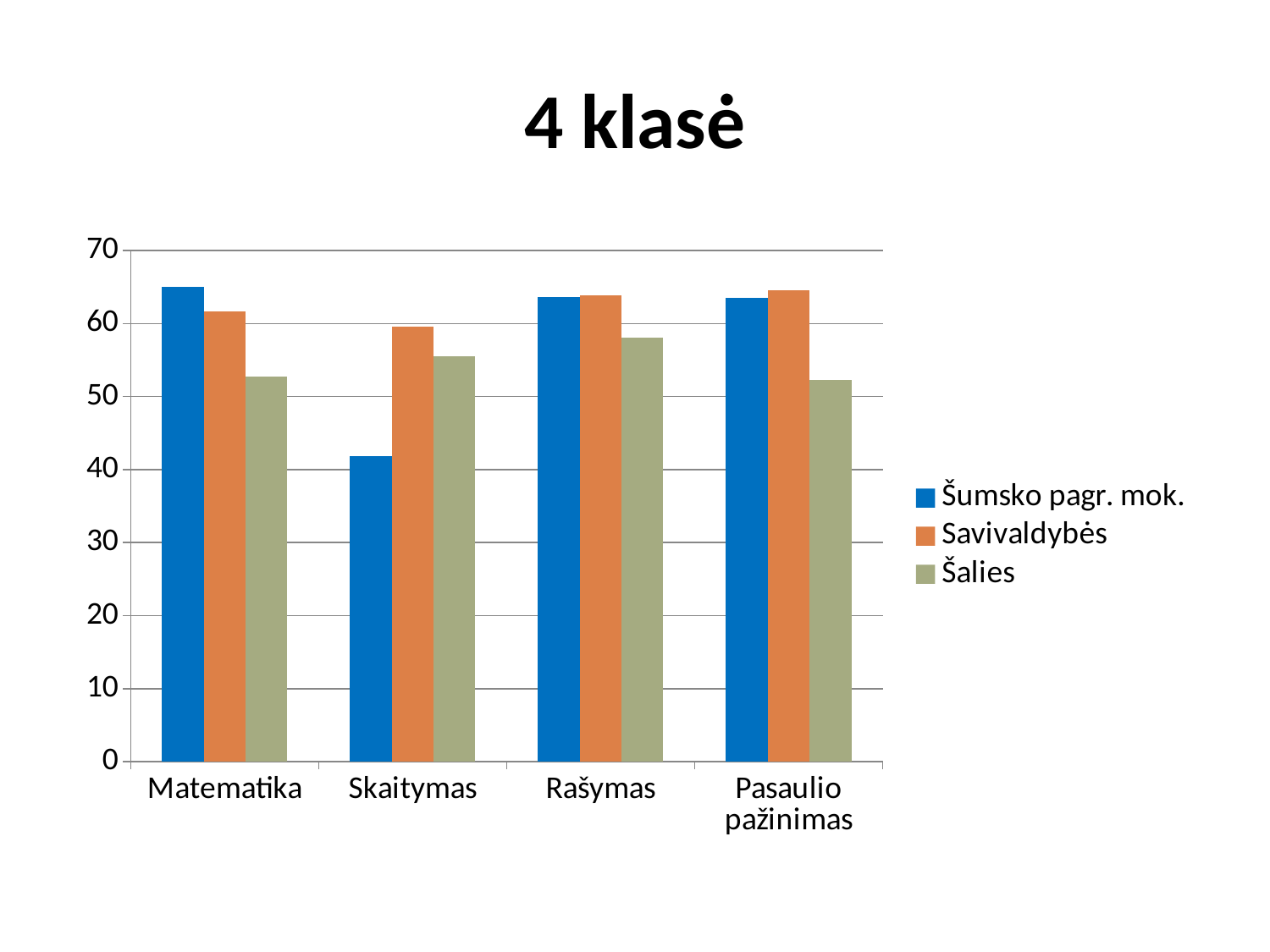
Is the Šumsko pagr. mok. value for Matematika greater or less than 60? greater What is the title of the chart? 4 klasė For Skaitymas, which is larger: the Šumsko pagr. mok. value or the Savivaldybės value? Savivaldybės For which category is the Šumsko pagr. mok. value lowest? Skaitymas Is the Šumsko pagr. mok. value for Skaitymas greater or less than 50? less Which series is shown in orange in the legend? Savivaldybės How many series does the legend list? 3 For Matematika, which is larger: the Šumsko pagr. mok. value or the Šalies value? Šumsko pagr. mok. What kind of chart is shown on the slide? bar chart For which category is the Savivaldybės value lowest? Skaitymas How many categories are shown on the x axis? 4 For which category is the Šalies value highest? Rašymas